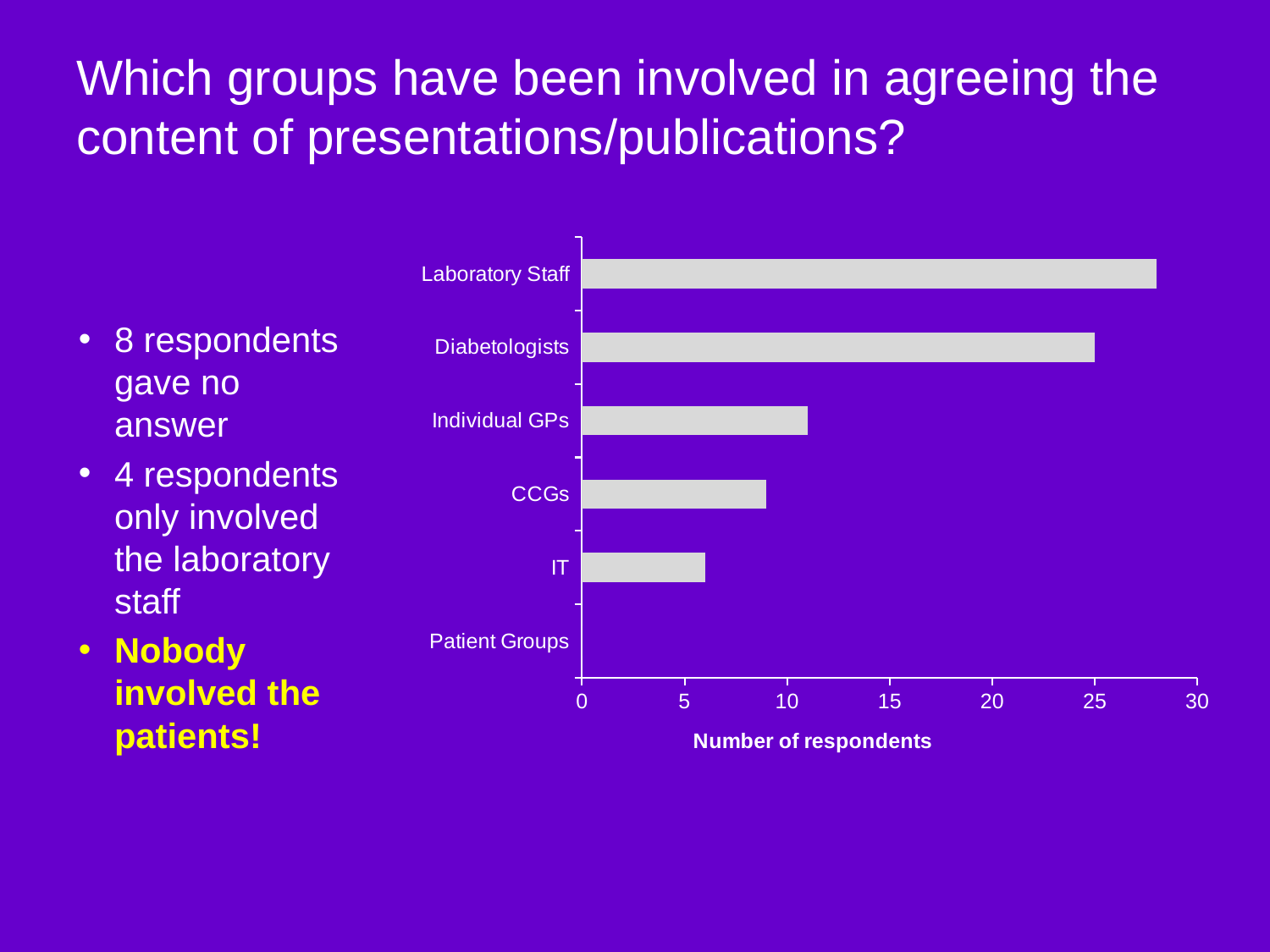
Which has more respondents, Individual GPs or CCGs? Individual GPs What is the number of respondents for Patient Groups? 0 Is the value for Individual GPs greater or less than 10? greater What kind of chart is shown on the slide? bar chart What is the title of the horizontal axis? Number of respondents Is the value for CCGs greater or less than 10? less Which group has the highest number of respondents? Laboratory Staff Is the value for Laboratory Staff greater or less than 25? greater What is the number of respondents for Diabetologists? 25 How many groups (categories) are shown on the chart? 6 Which group has the lowest number of respondents? Patient Groups